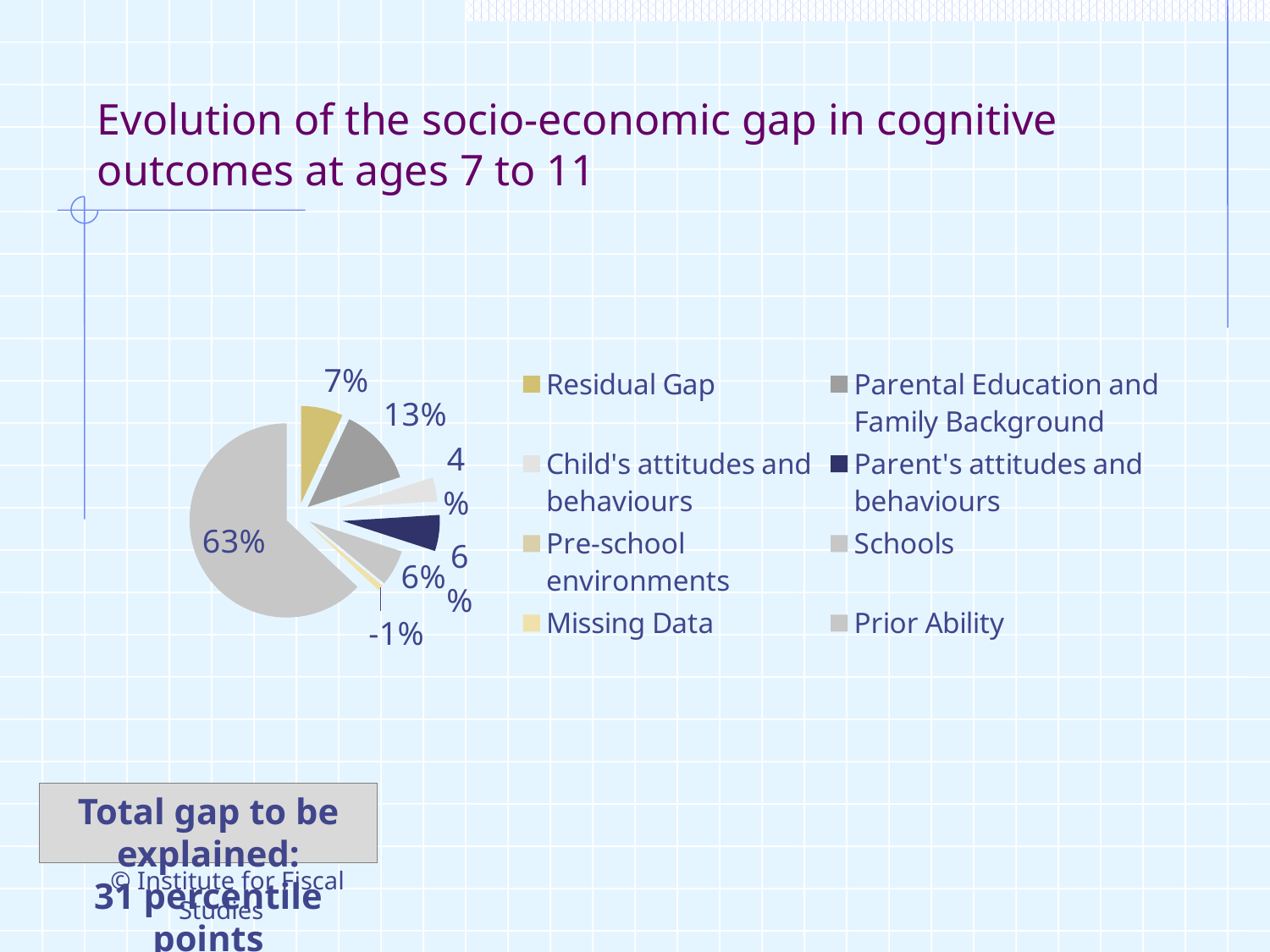
How many entries does the legend of the pie chart list? 8 What share of the gap is attributed to Parental Education and Family Background? 13% What kind of chart is shown on the slide? pie chart What share of the gap is attributed to Parent's attitudes and behaviours? 6% Which category accounts for the largest slice of the pie? Prior Ability What value is shown for Missing Data? -1% What share of the gap is attributed to Prior Ability? 63% Which category has the lowest value in the pie chart? Missing Data What share of the gap is the Residual Gap? 7% Which is larger: the share for Parental Education and Family Background or the Residual Gap? Parental Education and Family Background What is the difference between the Prior Ability share and the Parental Education and Family Background share? 50 percentage points According to the text box on the slide, what is the total gap to be explained? 31 percentile points